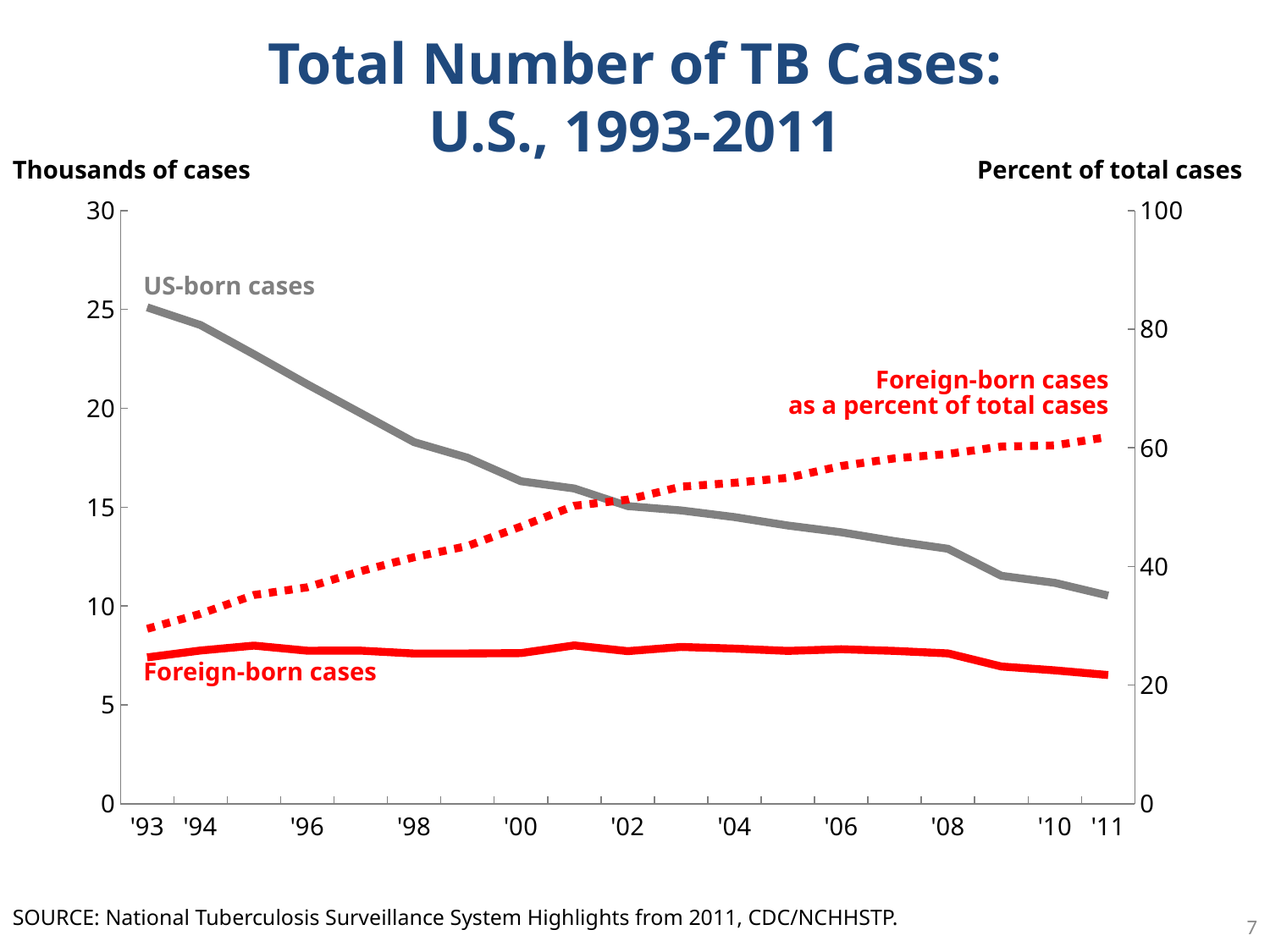
Does the number of US-born cases rise or fall from '93 to '11? fall Is the value for foreign-born cases as a percent of total cases in '11 greater or less than 50? greater Does the line for foreign-born cases as a percent of total cases rise or fall from '93 to '11? rise In which year are US-born cases highest? '93 Is the value for foreign-born cases as a percent of total cases in '93 greater or less than 40? less Is the value for US-born cases in '11 greater or less than 15 thousand? less In '11, which is larger: US-born cases or foreign-born cases (in thousands)? US-born cases What is the label of the right-hand vertical axis? Percent of total cases How many data series are plotted on the chart? 3 What kind of chart is shown on the slide? line chart In which year are US-born cases lowest? '11